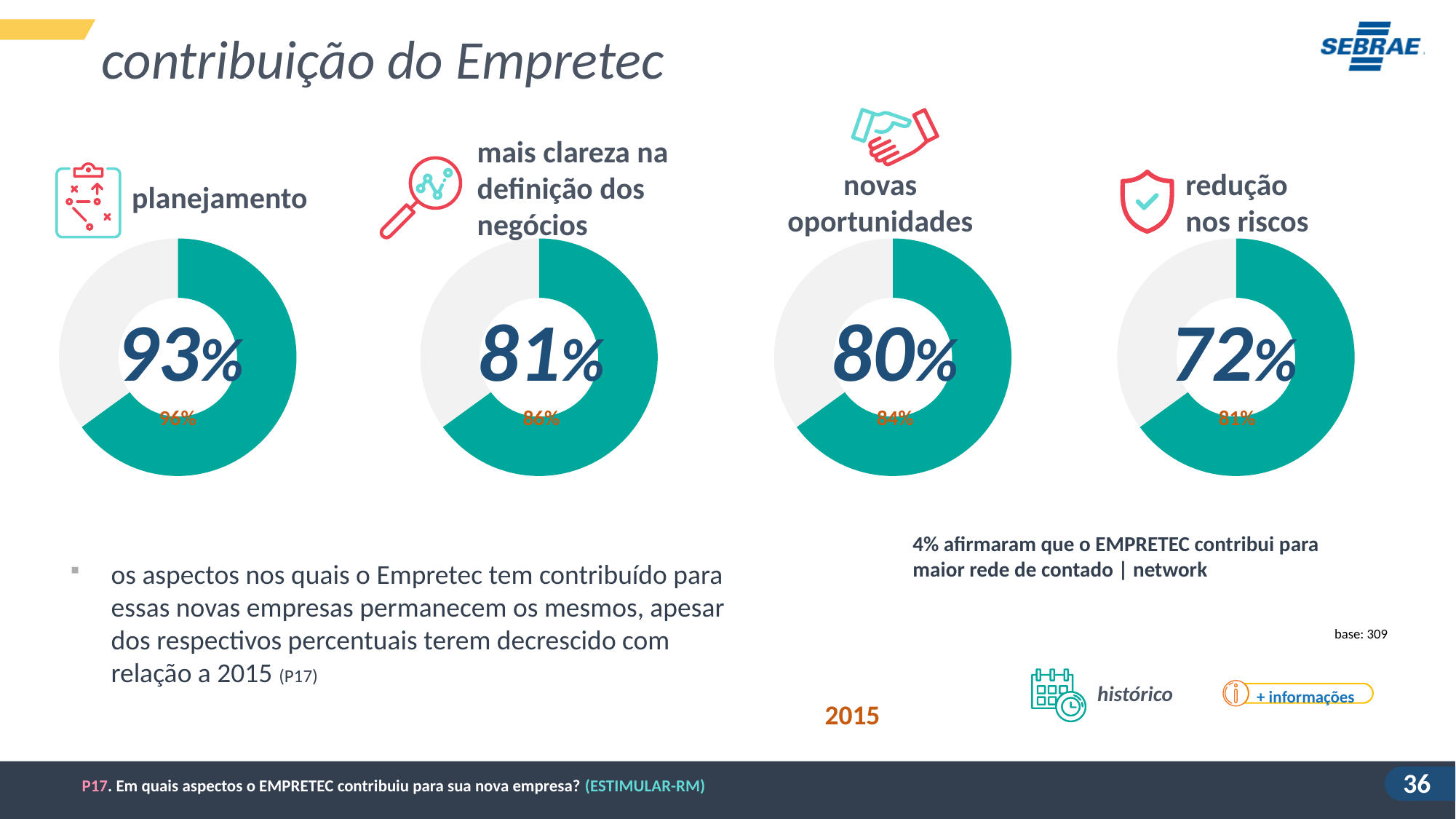
What percentage is shown in the 'planejamento' donut chart? 93% Which is larger, the 'mais clareza na definição dos negócios' percentage or the 'novas oportunidades' percentage? mais clareza na definição dos negócios What percentage is shown in the 'mais clareza na definição dos negócios' donut chart? 81% What is the difference between the 'redução nos riscos' 2015 value (81%) and its current value (72%)? 9% What percentage is shown in the 'novas oportunidades' donut chart? 80% In the 'planejamento' donut chart, what 2015 value is printed in orange below the main percentage? 96% How many donut charts are shown on the slide? 4 Which of the four donut charts shows the highest percentage? planejamento Which of the four donut charts shows the lowest percentage? redução nos riscos What is the difference between the 'planejamento' percentage and the 'redução nos riscos' percentage? 21% What percentage is shown in the 'redução nos riscos' donut chart? 72% What kind of chart is used to show the 'planejamento' percentage? donut chart